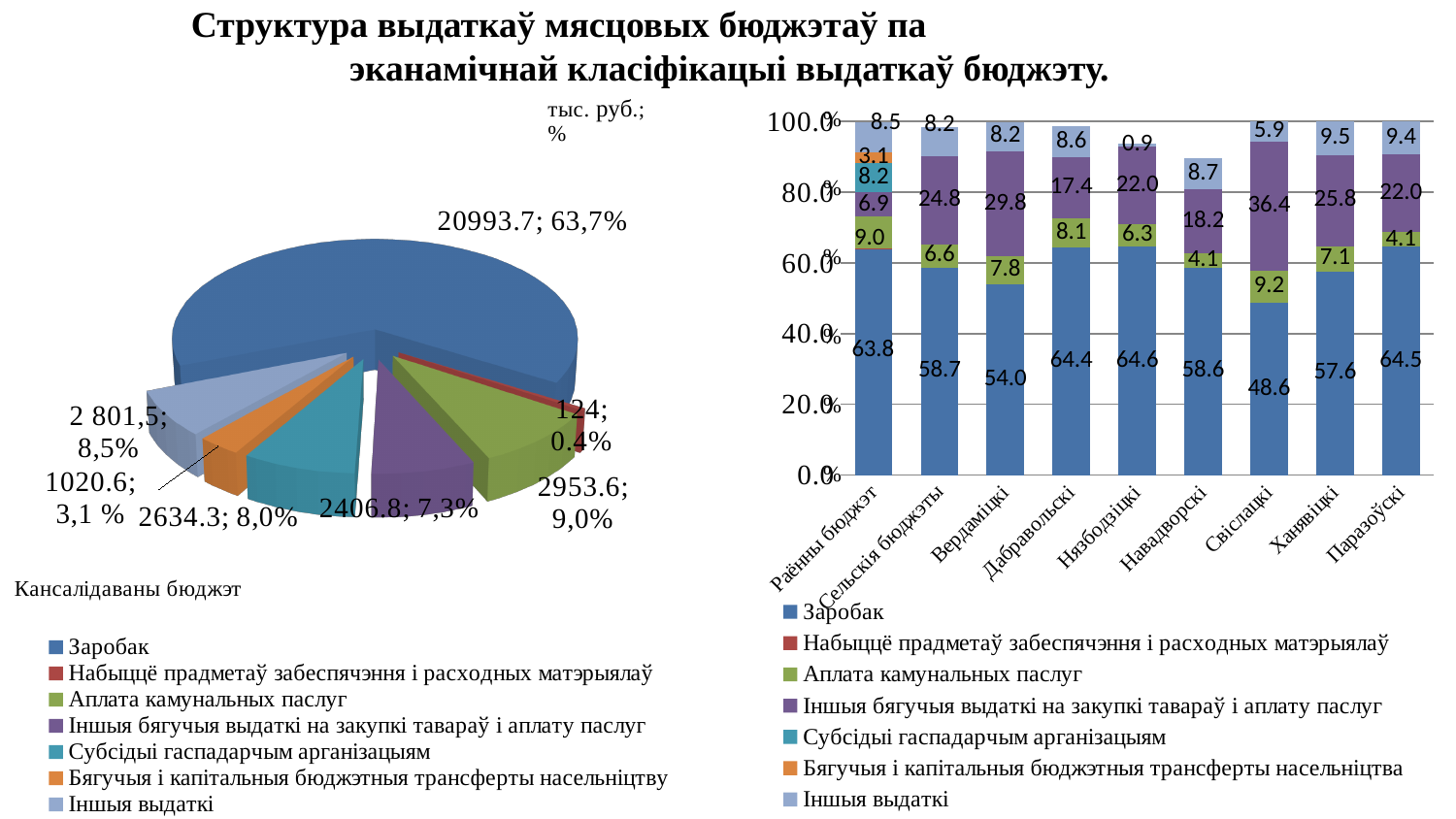
How many series does the legend of the stacked bar chart on the right list? 7 What kind of chart is the chart on the left of the slide? Pie chart What kind of chart is the chart on the right of the slide? Stacked bar chart In the stacked bar chart on the right, which category has the lowest Заробак value? Свіслацкі In the pie chart on the left, what percentage share does Заробак have? 63,7% How many categories are shown on the x axis of the stacked bar chart on the right? 9 In the stacked bar chart on the right, what is the difference between the Заробак values for Раённы бюджэт and Сельскія бюджэты? 5.1 In the pie chart on the left, what value is shown for Субсідыі гаспадарчым арганізацыям? 2634.3 In the stacked bar chart on the right, what is the value of Іншыя бягучыя выдаткі на закупкі тавараў і аплату паслуг for Свіслацкі? 36.4 In the stacked bar chart on the right, what is the Заробак value for Свіслацкі? 48.6 In the pie chart on the left, which category has the smallest slice? Набыццё прадметаў забеспячэння і расходных матэрыялаў In the stacked bar chart on the right, which has the larger Заробак value: Вердаміцкі or Дабравольскі? Дабравольскі